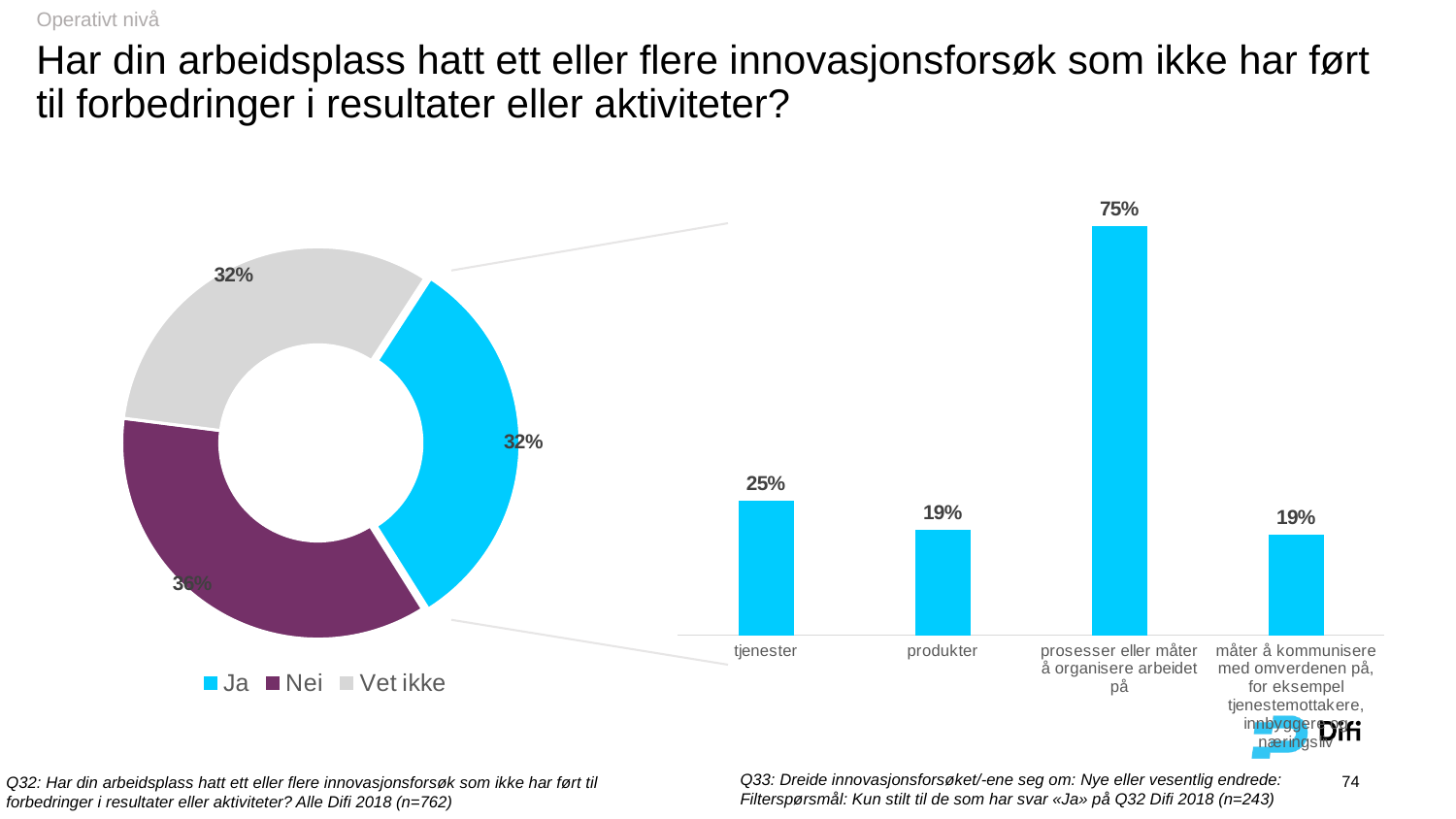
In the donut chart on the left, what share of respondents answered "Nei"? 36% In the bar chart on the right, what is the value for "tjenester"? 25% In the bar chart on the right, what is the value for "prosesser eller måter å organisere arbeidet på"? 75% How many entries does the legend of the donut chart on the left list? 3 In the donut chart on the left, what share of respondents answered "Ja"? 32% In the bar chart on the right, what is the value for "produkter"? 19% How many categories are shown in the bar chart on the right? 4 In the bar chart on the right, what is the difference between the values for "prosesser eller måter å organisere arbeidet på" and "tjenester"? 50% In the donut chart on the left, what share of respondents answered "Vet ikke"? 32% What kind of chart is on the right side of the slide? Bar chart In the bar chart on the right, which category has the highest value? prosesser eller måter å organisere arbeidet på What kind of chart is on the left side of the slide? Donut (pie) chart